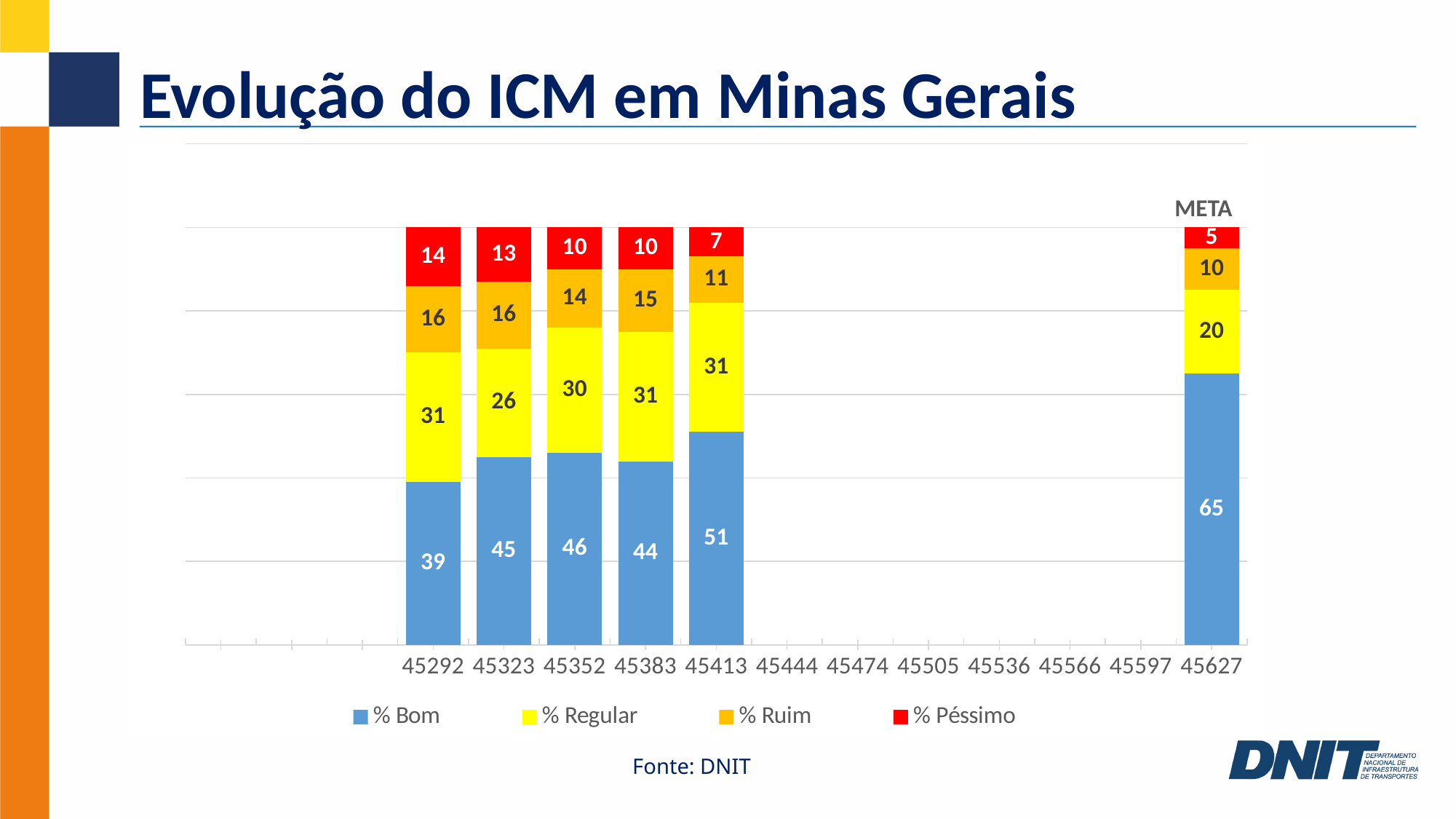
Which bar has the highest % Bom value? 45627 (META) What is the % Regular value for the META bar (45627)? 20 How many series does the legend list? 4 How many bars are plotted on the chart? 6 What kind of chart is shown on the slide? Stacked bar chart What is the difference between the % Bom values for 45413 and 45292? 12 Is the % Ruim value larger for 45292 or for 45413? 45292 Which series is shown in red in the legend? % Péssimo What is the % Péssimo value for the bar labelled 45413? 7 Among the bars 45292 to 45413, which has the lowest % Bom value? 45292 What is the % Bom value for the bar labelled 45292? 39 What is the total of the stacked bar labelled 45352? 100